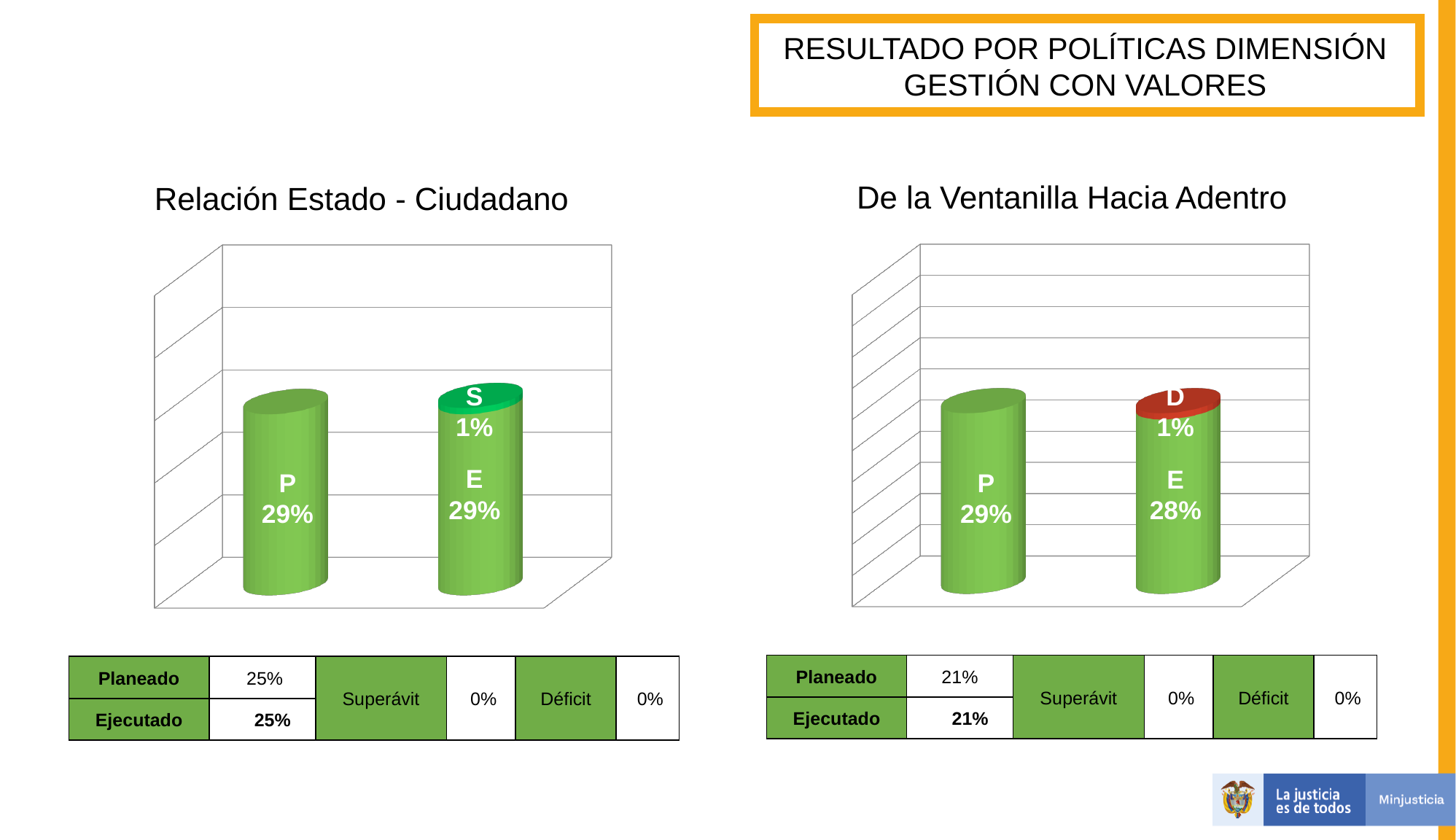
What is the title of the chart on the left side of the slide? Relación Estado - Ciudadano In the 'Relación Estado - Ciudadano' chart, what value is shown on the P bar? 29% In the 'De la Ventanilla Hacia Adentro' chart, what is the difference between the P value and the E value? 1% How many bars are plotted in the 'Relación Estado - Ciudadano' chart? 2 In the 'Relación Estado - Ciudadano' chart, what value is shown for the S segment on top of the E bar? 1% In the 'Relación Estado - Ciudadano' chart, what is the total of the stacked E bar (E plus S)? 30% In the 'De la Ventanilla Hacia Adentro' chart, what value is shown on the P bar? 29% In the 'De la Ventanilla Hacia Adentro' chart, what value is shown for the D segment on top of the E bar? 1% What kind of chart is the 'De la Ventanilla Hacia Adentro' chart? Bar chart In the 'De la Ventanilla Hacia Adentro' chart, what value is shown for the E segment? 28% In the 'Relación Estado - Ciudadano' chart, what value is shown for the E segment? 29% In the 'De la Ventanilla Hacia Adentro' chart, which is larger, the P value or the E value? P